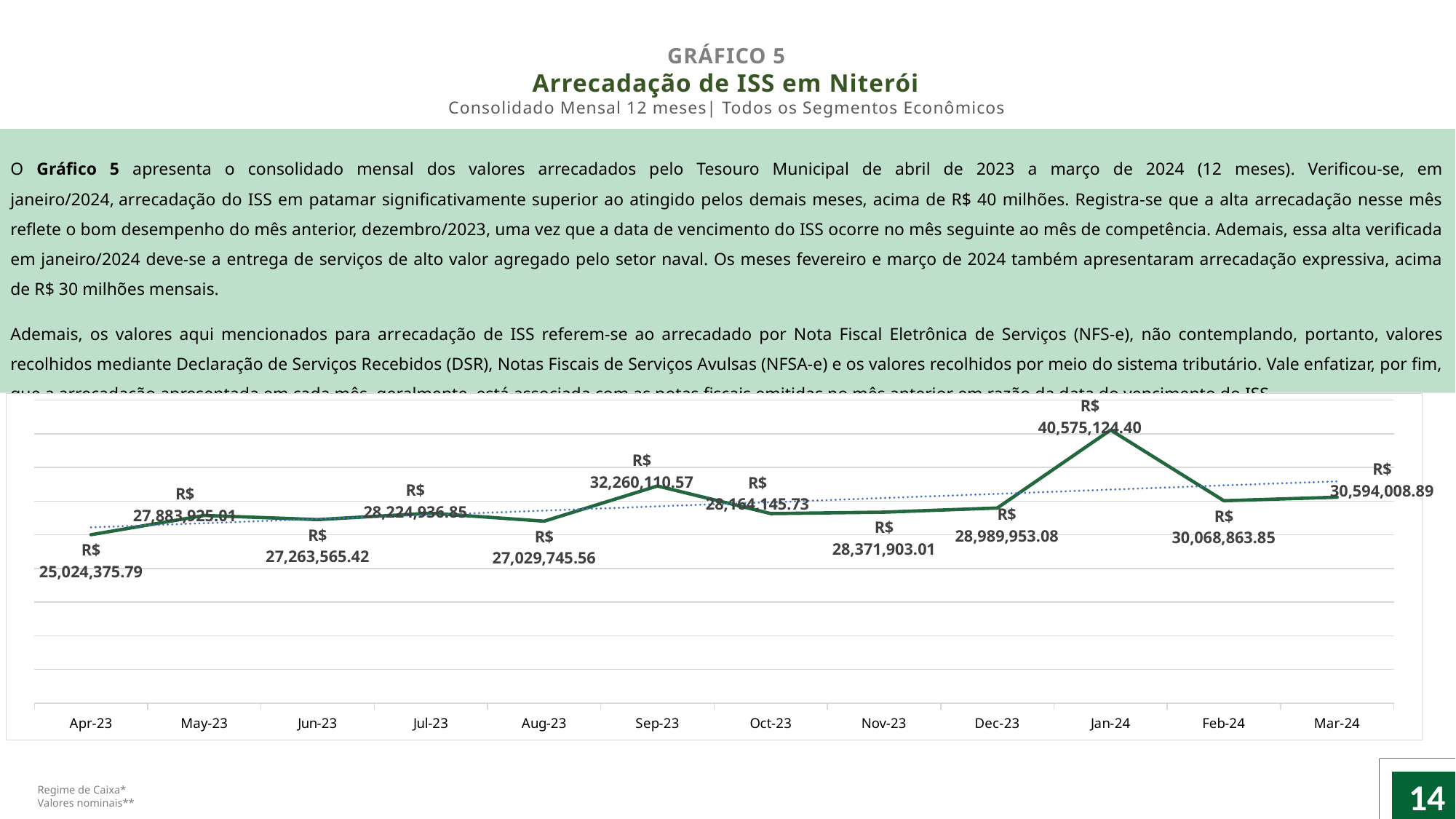
Which month has the highest ISS collection value? Jan-24 What type of chart is shown on the slide? line chart Which month has the lowest ISS collection value? Apr-23 What is the ISS collection value for Jan-24? R$ 40,575,124.40 What is the ISS collection value for Apr-23? R$ 25,024,375.79 What is the ISS collection value for Mar-24? R$ 30,594,008.89 What is the ISS collection value for Sep-23? R$ 32,260,110.57 Does the ISS collection value rise or fall from Apr-23 to May-23? rise Which is larger, the value for Feb-24 or the value for Dec-23? Feb-24 How many months are plotted on the x axis? 12 What is the difference between the Jan-24 value and the Apr-23 value? R$ 15,550,748.61 What is the difference between the Sep-23 value and the Aug-23 value? R$ 5,230,365.01